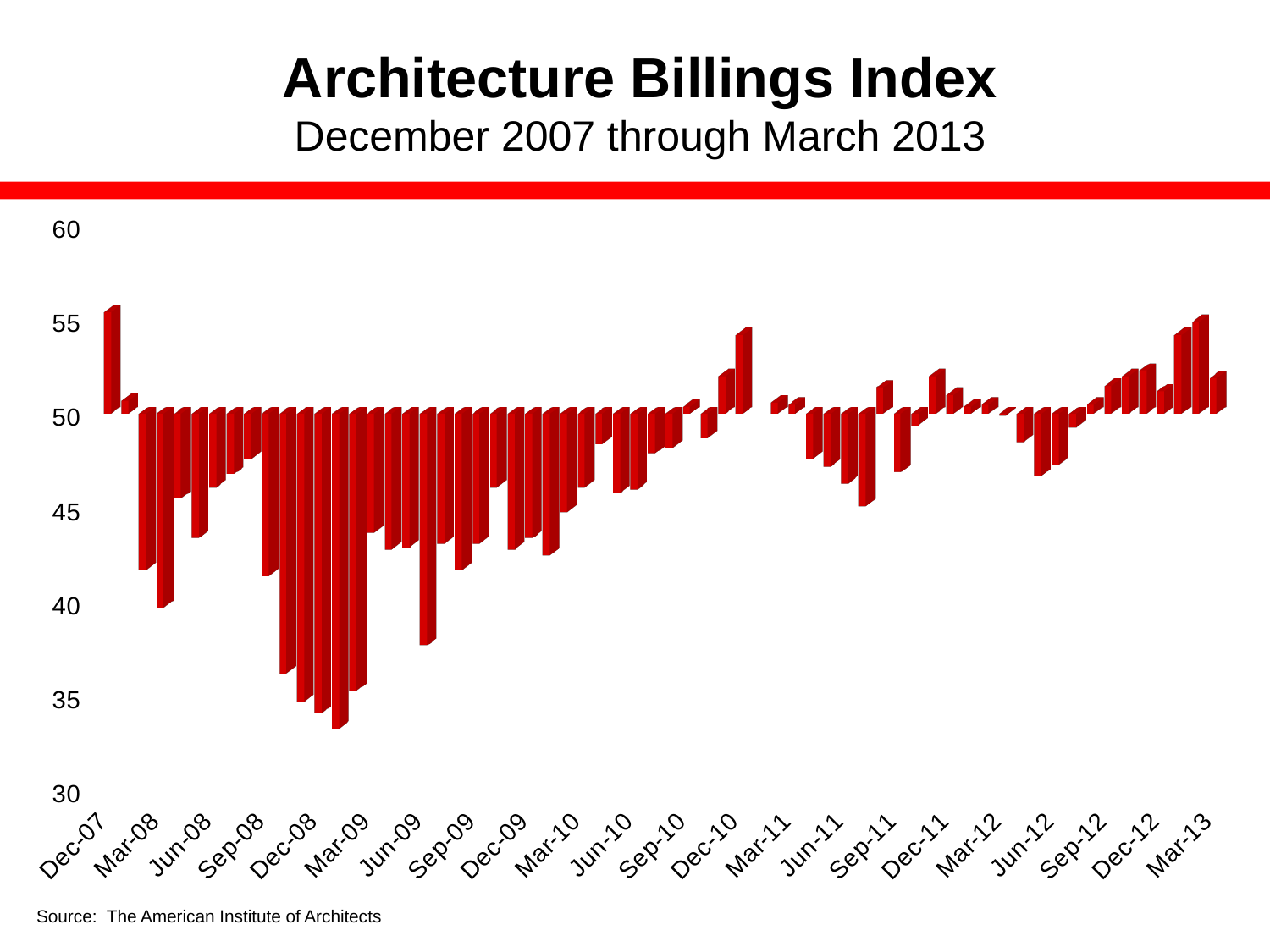
What is the title of the chart? Architecture Billings Index Do the values generally rise or fall from Dec-08 to Dec-10? rise What kind of chart is shown on the slide? bar chart How many date labels are shown along the x axis? 22 Is the value for Mar-09 greater or less than 40? greater Is the value for Dec-10 greater or less than 50? greater Is the value for Mar-13 greater or less than 50? greater What period does the chart's subtitle say it covers? December 2007 through March 2013